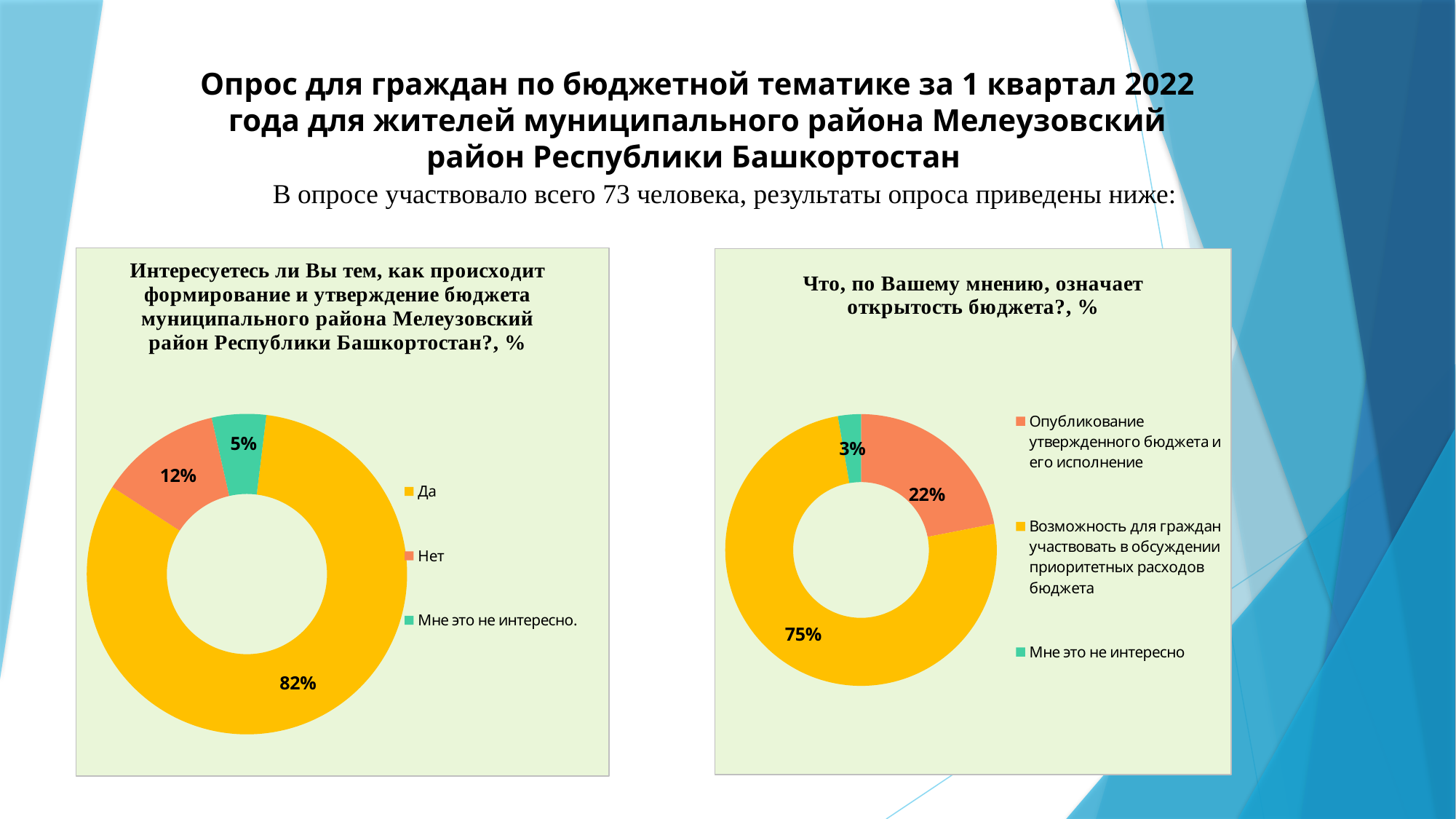
In the right chart, what percentage chose "Мне это не интересно"? 3% In the left chart, what percentage answered "Нет"? 12% In the left chart, which answer has the smallest share? Мне это не интересно. In the left chart, what percentage answered "Мне это не интересно."? 5% In the left chart, which answer has the largest share? Да What type of chart is the left chart? Doughnut (pie) chart How many entries does the legend of the right chart list? 3 In the right chart, which answer has the largest share? Возможность для граждан участвовать в обсуждении приоритетных расходов бюджета In the left chart, what is the difference in percentage points between "Да" and "Нет"? 70 In the left chart (Интересуетесь ли Вы тем, как происходит формирование и утверждение бюджета...), what percentage answered "Да"? 82% In the right chart, what percentage chose "Возможность для граждан участвовать в обсуждении приоритетных расходов бюджета"? 75% In the right chart (Что, по Вашему мнению, означает открытость бюджета?), what percentage chose "Опубликование утвержденного бюджета и его исполнение"? 22%